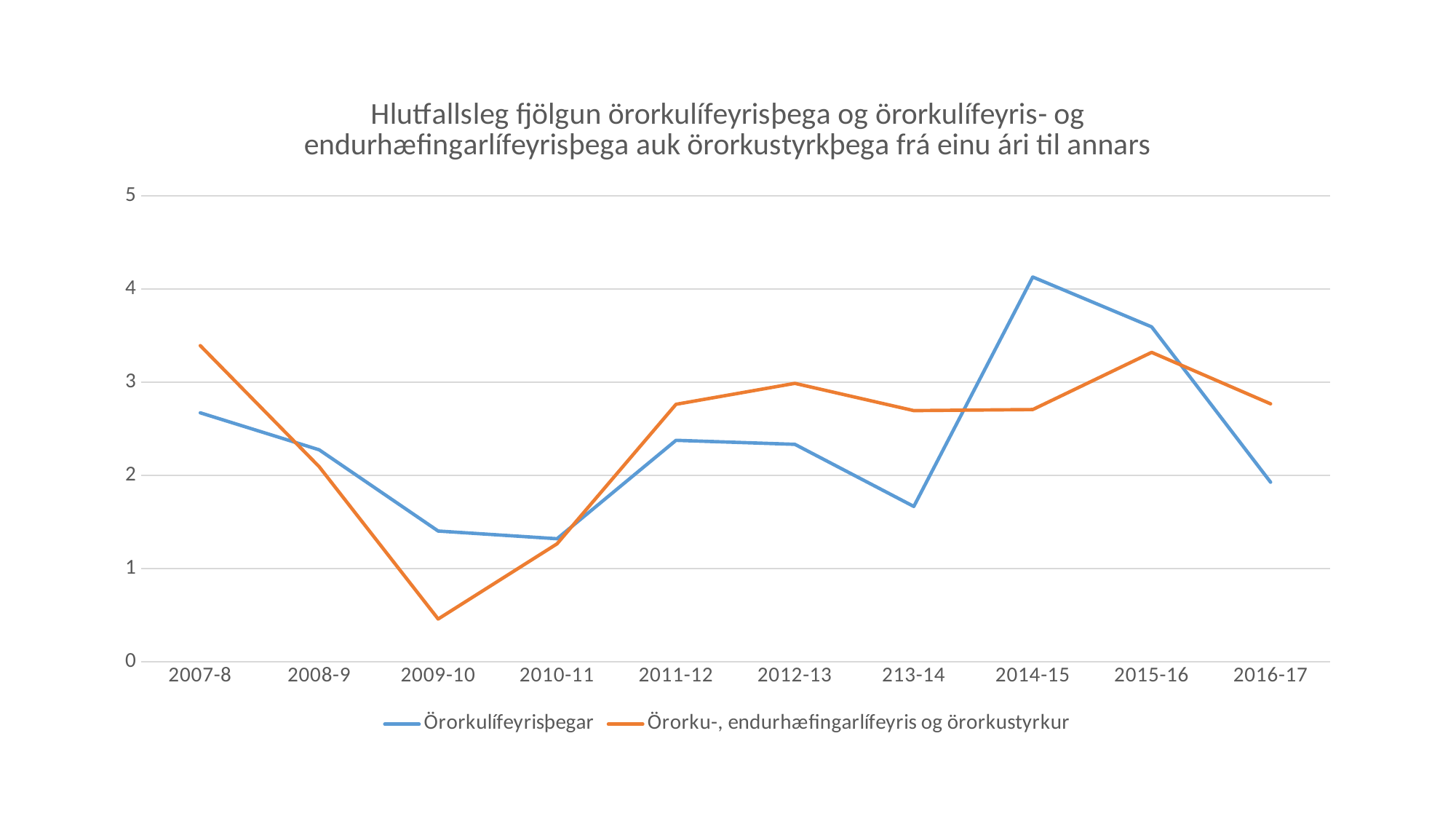
Is the value for Örorkulífeyrisþegar in 2014-15 greater or less than 4? greater Is the value for Örorkulífeyrisþegar in 2016-17 greater or less than 2? less In 2014-15, which series has the larger value, Örorkulífeyrisþegar or Örorku-, endurhæfingarlífeyris og örorkustyrkur? Örorkulífeyrisþegar What kind of chart is shown on the slide? line chart Is the value for Örorku-, endurhæfingarlífeyris og örorkustyrkur in 2007-8 greater or less than 3? greater Does the Örorkulífeyrisþegar series rise or fall from 2007-8 to 2010-11? fall How many series does the legend list? 2 In which period does the Örorku-, endurhæfingarlífeyris og örorkustyrkur series reach its lowest value? 2009-10 In 2007-8, which series has the larger value, Örorkulífeyrisþegar or Örorku-, endurhæfingarlífeyris og örorkustyrkur? Örorku-, endurhæfingarlífeyris og örorkustyrkur How many periods are plotted along the x axis? 10 In which period does the Örorkulífeyrisþegar series reach its highest value? 2014-15